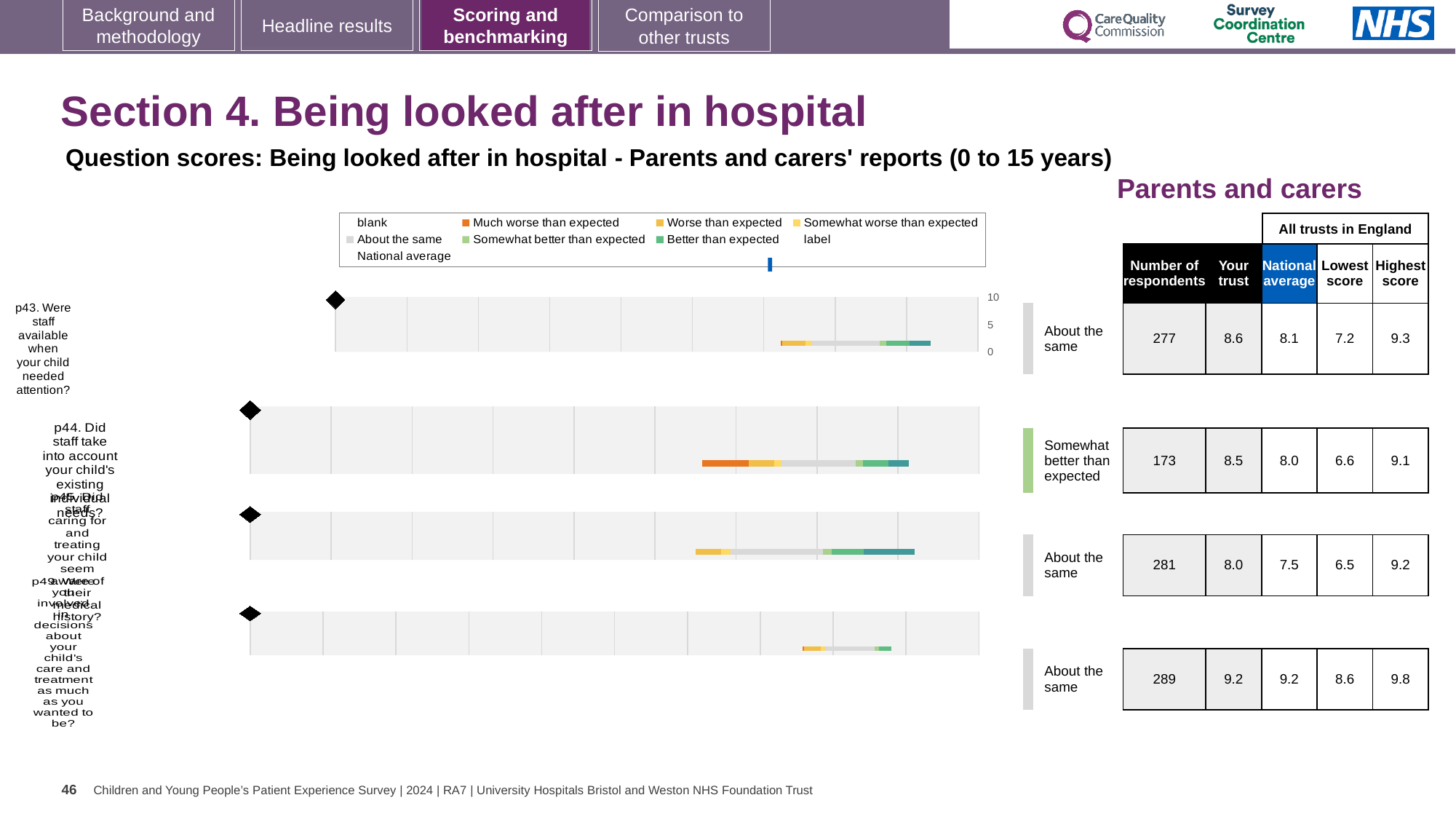
What is the highest score across all trusts in England for p43? 9.3 What benchmark category is shown for p43? About the same How many respondents are listed for p43 (Were staff available when your child needed attention?)? 277 What is the difference between the 'Your trust' score and the national average for p43? 0.5 How many questions (bars) are plotted in the chart? 4 What kind of chart is shown on the slide? bar chart Which question row has the lowest 'Lowest score' value? The third row, p45, with 6.5 What is the 'Your trust' score for p43 (Were staff available when your child needed attention?)? 8.6 What heading appears above the table to the right of the chart? Parents and carers Which question row has the highest 'Your trust' score? The fourth (bottom) row, p49, with 9.2 For p43, which is larger: the 'Your trust' score or the national average? Your trust (8.6) What is the national average score for p43 (Were staff available when your child needed attention?)? 8.1